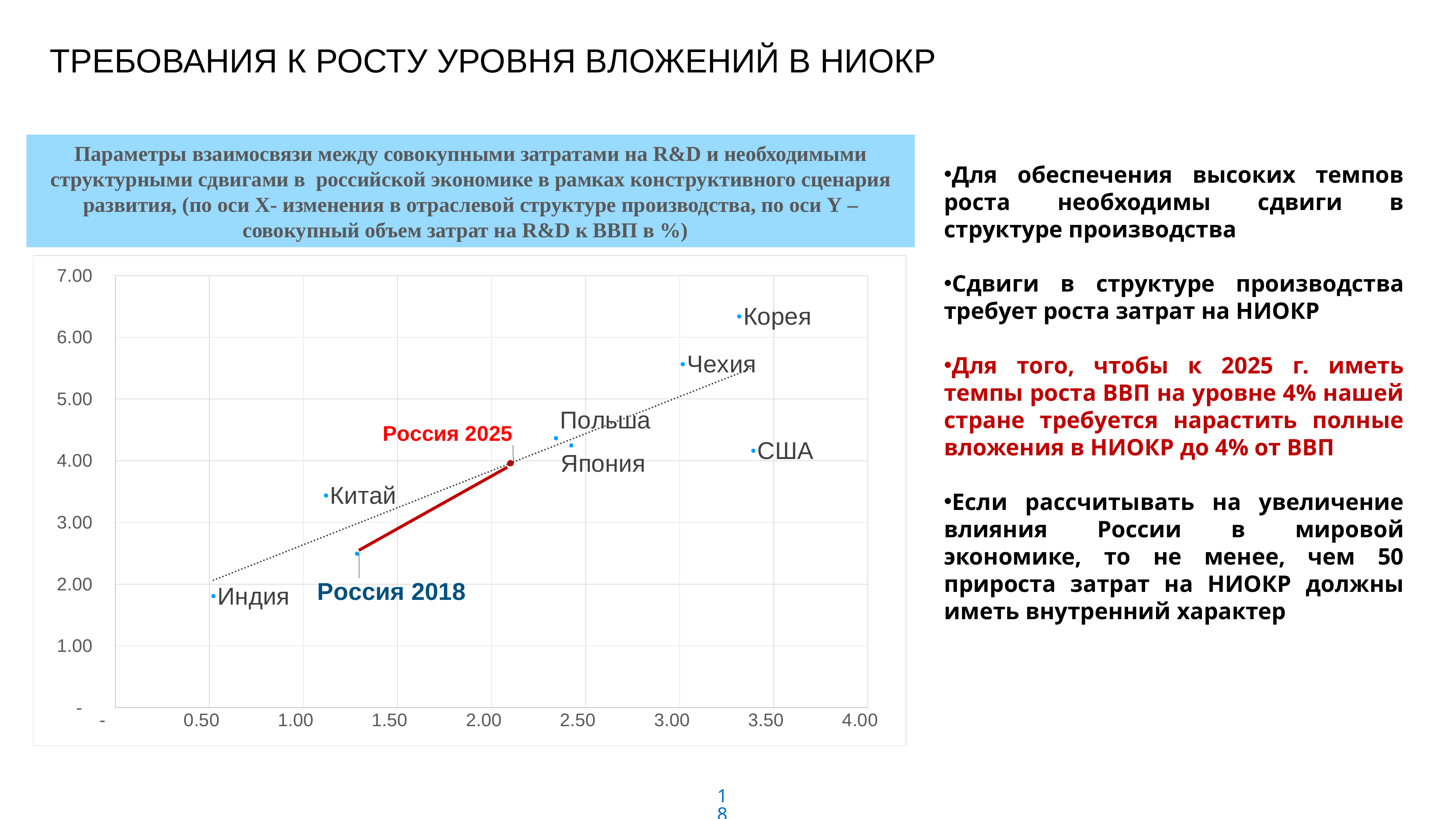
Which labeled point is furthest to the left on the horizontal axis? Индия Is the vertical-axis value for США greater or less than 5.00? less How many labeled data points are plotted on the chart? 9 Which has the higher vertical-axis value, Россия 2025 or Россия 2018? Россия 2025 What kind of chart is shown on the slide? scatter chart Do the plotted points generally rise or fall as the horizontal-axis value increases? rise Which has the higher vertical-axis value, Корея or США? Корея Which labeled point has the highest value on the vertical axis? Корея Is the vertical-axis value for Россия 2018 greater or less than 2.00? greater Which labeled point has the lowest value on the vertical axis? Индия Is the vertical-axis value for Китай greater or less than 3.00? greater